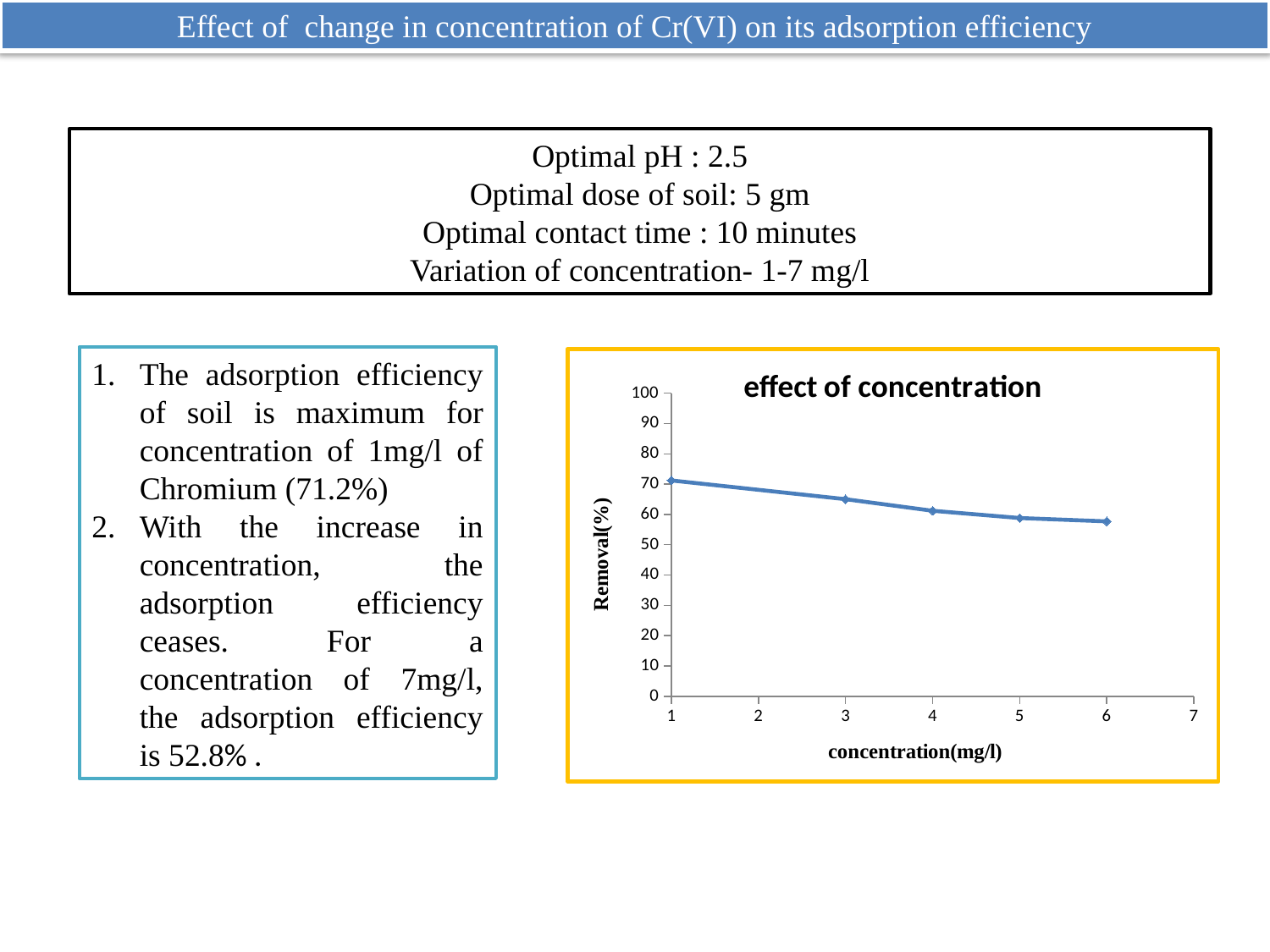
Is the removal value at a concentration of 4 mg/l greater or less than 70? less Which has the larger removal value: concentration 1 mg/l or concentration 6 mg/l? 1 mg/l How many data points are plotted on the line? 5 Is the removal value at a concentration of 1 mg/l greater or less than 60? greater Does the removal percentage rise or fall as concentration increases along the x axis? fall Is the removal value at a concentration of 3 mg/l greater or less than 70? less At which concentration (mg/l) is the removal percentage highest? 1 What is the label of the y axis? Removal(%) What kind of chart is shown on the slide? line chart What is the title of the chart? effect of concentration